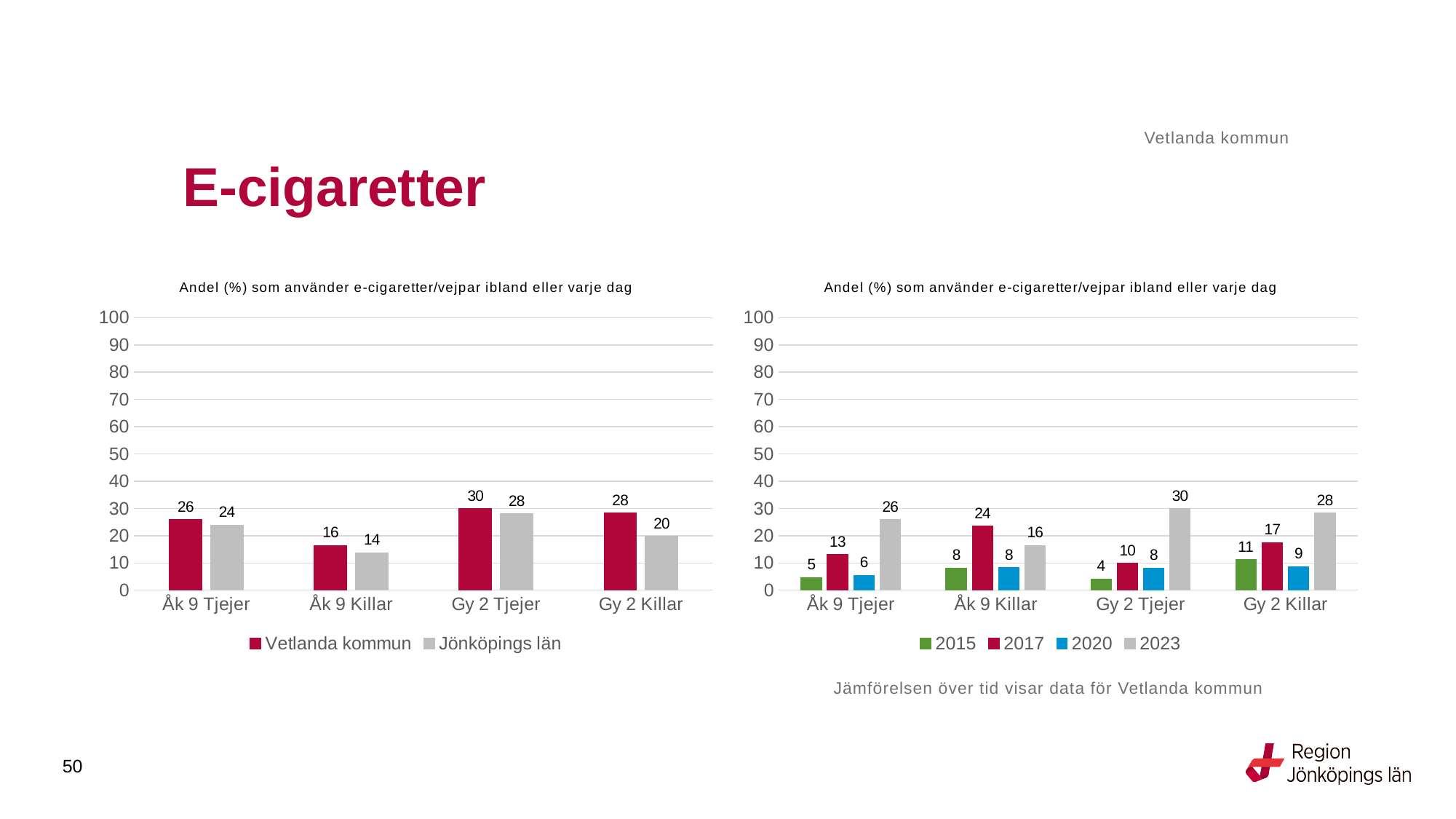
In the right chart, how many series does the legend list? 4 In the right chart, what is the value for 2017 for Åk 9 Killar? 24 In the left chart, what is the value for Vetlanda kommun for Gy 2 Killar? 28 In the right chart, what is the value for 2023 for Gy 2 Tjejer? 30 In the right chart, which category has the lowest value for 2015? Gy 2 Tjejer In the left chart, what is the difference between Vetlanda kommun and Jönköpings län for Gy 2 Killar? 8 In the left chart, which category has the highest value for Vetlanda kommun? Gy 2 Tjejer What kind of chart is the left chart? Bar chart In the left chart, what is the value for Jönköpings län for Åk 9 Killar? 14 In the right chart, what is the difference between the 2023 and 2015 values for Åk 9 Tjejer? 21 In the right chart, which is larger for Åk 9 Tjejer: the value for 2017 or the value for 2023? 2023 In the left chart, how many series does the legend list? 2